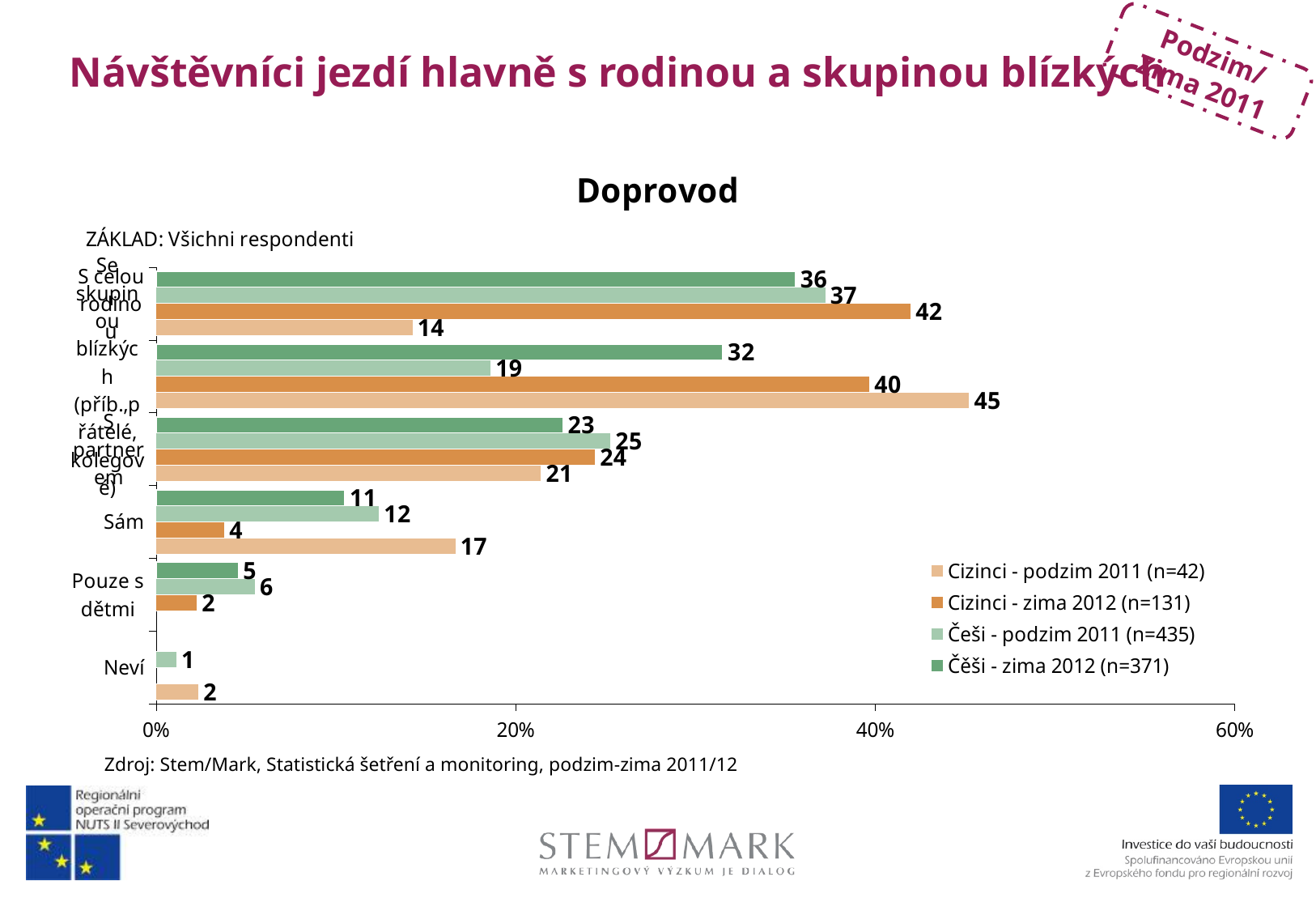
What is the value for 'Češi - podzim 2011 (n=435)' in the 'Pouze s dětmi' category? 6 What is the value for 'Cizinci - zima 2012 (n=131)' in the 'Sám' category? 4 What kind of chart is shown on the slide? bar chart How many series does the legend list? 4 How many categories are shown on the vertical axis of the chart? 6 What is the title of the chart? Doprovod What is the difference between the 'Cizinci - podzim 2011 (n=42)' and 'Cizinci - zima 2012 (n=131)' values in the 'Sám' category? 13 What is the highest value labelled anywhere in the chart? 45 What is the value for 'Češi - zima 2012 (n=371)' in the 'Pouze s dětmi' category? 5 In the 'Sám' category, which is larger: the value for 'Češi - podzim 2011 (n=435)' or for 'Cizinci - zima 2012 (n=131)'? Češi - podzim 2011 (n=435) What is the value for 'Cizinci - podzim 2011 (n=42)' in the 'Neví' category? 2 What is the value for 'Cizinci - podzim 2011 (n=42)' in the 'Sám' category? 17